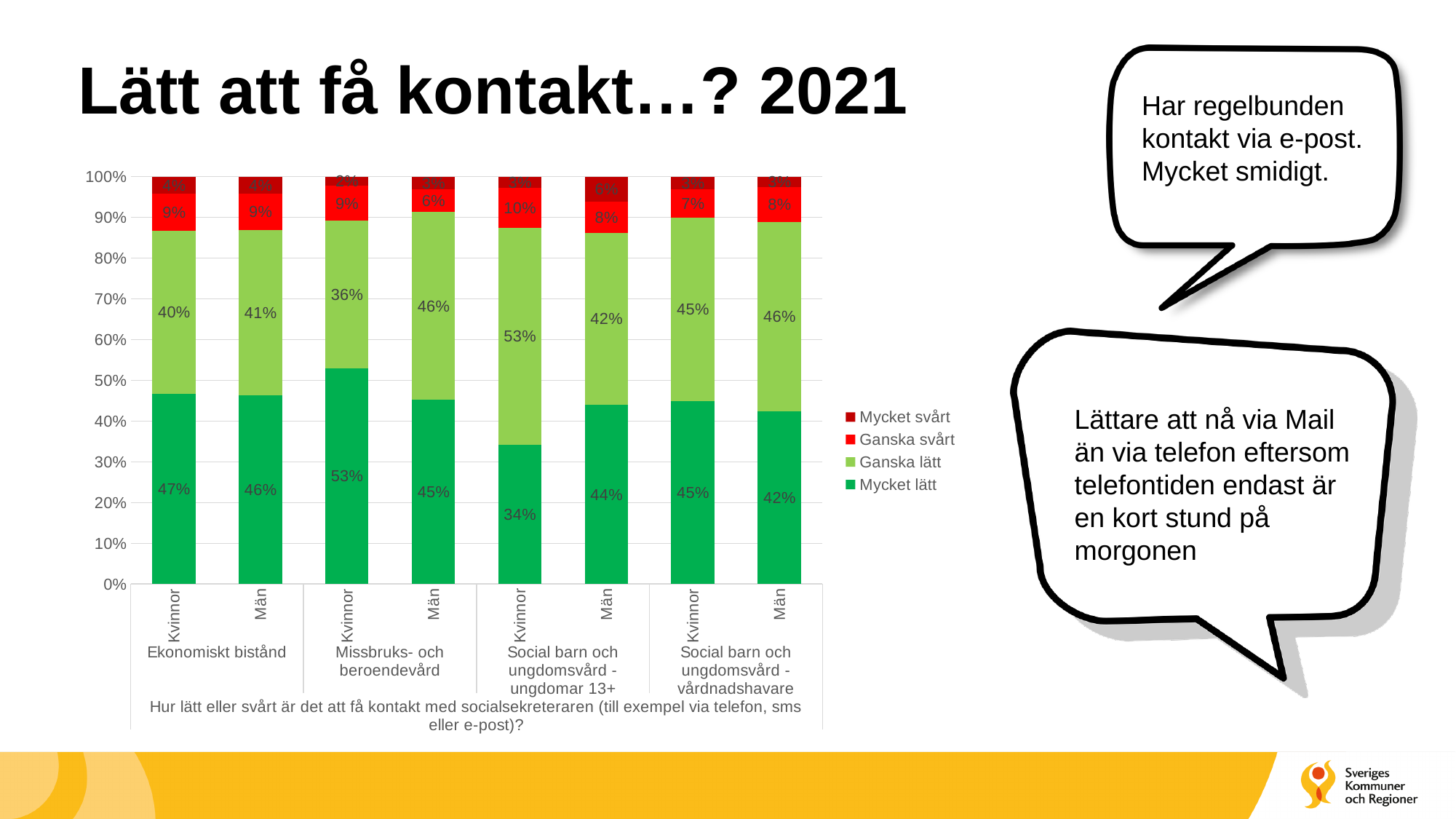
What is the 'Mycket svårt' value for Män in Social barn och ungdomsvård - ungdomar 13+? 6% What kind of chart is shown on the slide? Stacked bar chart Which bar has the lowest 'Mycket lätt' value? Kvinnor, Social barn och ungdomsvård - ungdomar 13+ What is the 'Ganska svårt' value for Män in Missbruks- och beroendevård? 6% What is the difference between the 'Mycket lätt' values for Kvinnor and Män in Social barn och ungdomsvård - vårdnadshavare? 3% What is the 'Ganska lätt' value for Kvinnor in Social barn och ungdomsvård - ungdomar 13+? 53% Which bar has the highest 'Mycket lätt' value? Kvinnor, Missbruks- och beroendevård How many series does the legend list? 4 Which legend entry is shown in dark red? Mycket svårt Which is larger: the 'Ganska lätt' value for Kvinnor or for Män in Missbruks- och beroendevård? Män How many bars are plotted in the chart? 8 What is the 'Mycket lätt' value for Kvinnor in Ekonomiskt bistånd? 47%